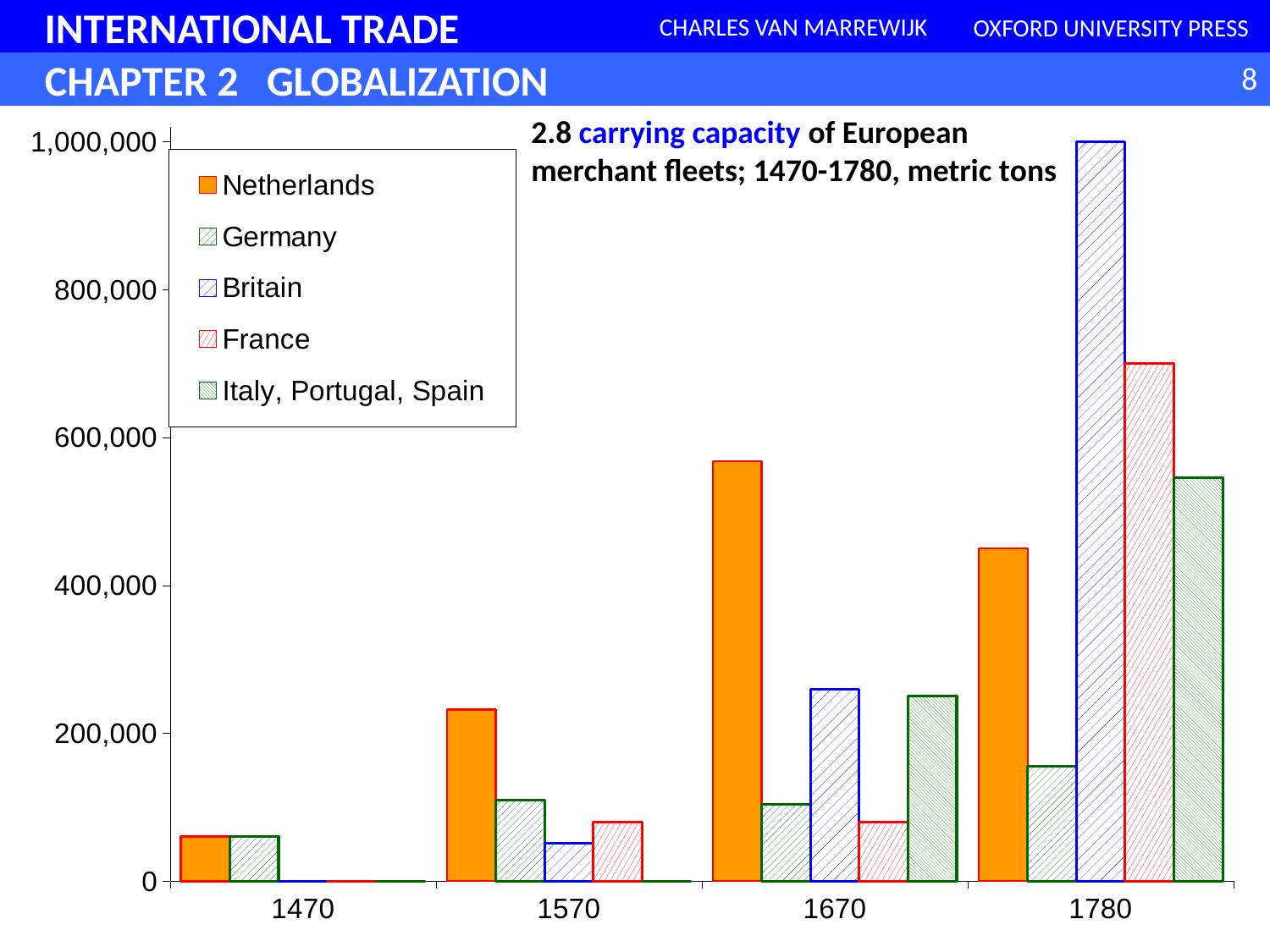
Is the value for France in 1780 greater or less than 600,000? greater What kind of chart is shown on the slide? bar chart How many series does the legend list? 5 In 1670, which is larger: the Netherlands or Britain? Netherlands What is the title of the chart? 2.8 carrying capacity of European merchant fleets; 1470-1780, metric tons In which year is the Britain bar the highest? 1780 In 1780, which is larger: Britain or France? Britain Is the value for the Netherlands in 1670 greater or less than 400,000? greater Do the values for Britain rise or fall from 1470 to 1780? rise Which series has the lowest value in 1570? Italy, Portugal, Spain How many years are shown on the x axis? 4 Is the value for Germany in 1780 greater or less than 200,000? less